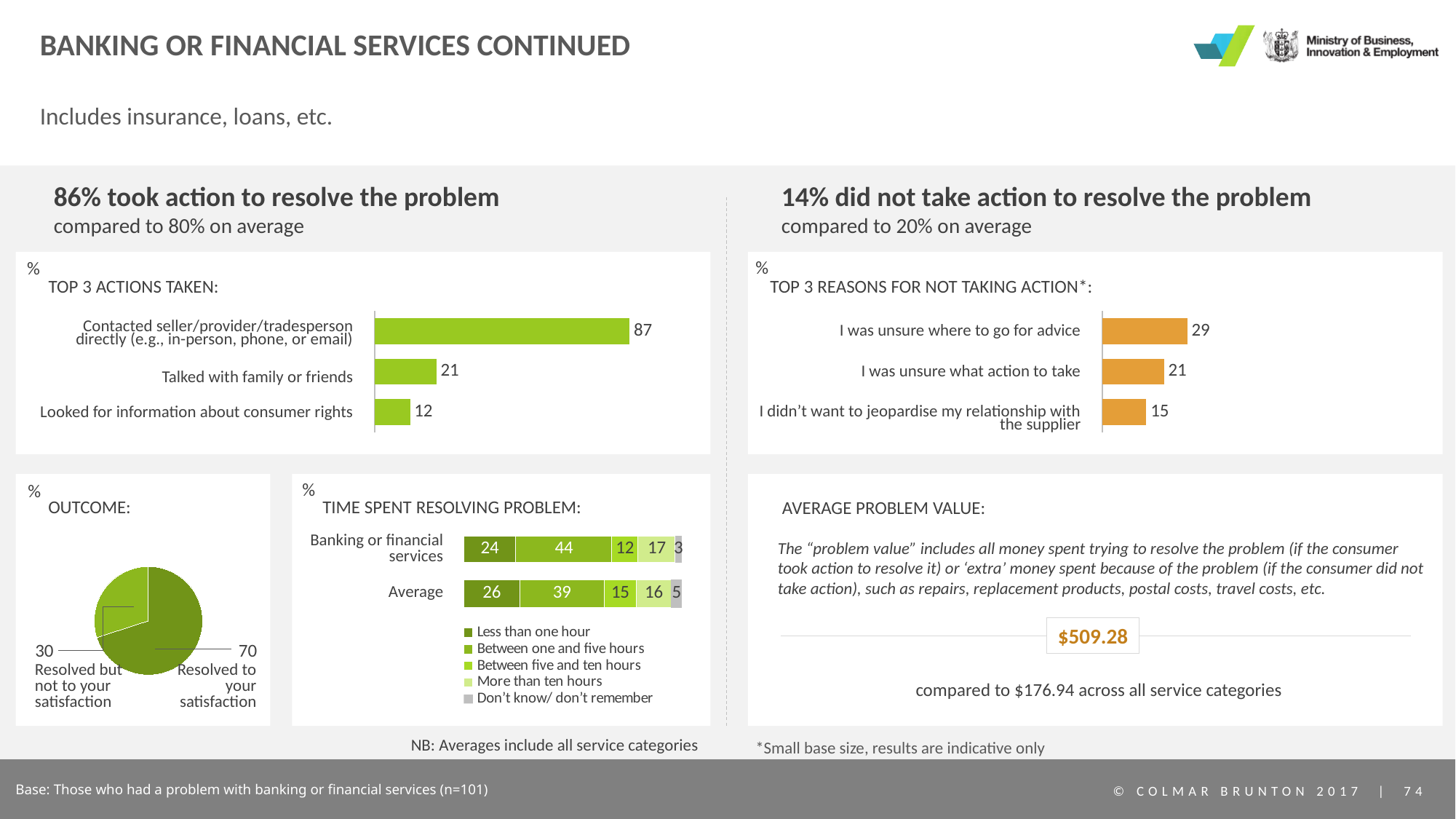
In the 'Outcome' pie chart, what percentage was resolved to your satisfaction? 70 In the 'Time spent resolving problem' chart, which is larger for 'Less than one hour': banking or financial services or the average? Average In the 'Time spent resolving problem' chart, what is the total of the 'Average' stacked bar? 101 In the 'Top 3 reasons for not taking action' chart, which reason has the highest value? I was unsure where to go for advice What kind of chart is the 'Outcome' chart? Pie chart In the 'Top 3 actions taken' chart, what percentage contacted the seller/provider/tradesperson directly? 87 In the 'Time spent resolving problem' chart, how many series does the legend list? 5 In the 'Top 3 actions taken' chart, what is the difference between 'Talked with family or friends' and 'Looked for information about consumer rights'? 9 In the 'Top 3 actions taken' chart, which action has the lowest value? Looked for information about consumer rights In the 'Top 3 reasons for not taking action' chart, what is the value for 'I was unsure where to go for advice'? 29 In the 'Time spent resolving problem' chart, what is the 'Between one and five hours' value for banking or financial services? 44 In the 'Top 3 reasons for not taking action' chart, how many reasons are shown? 3